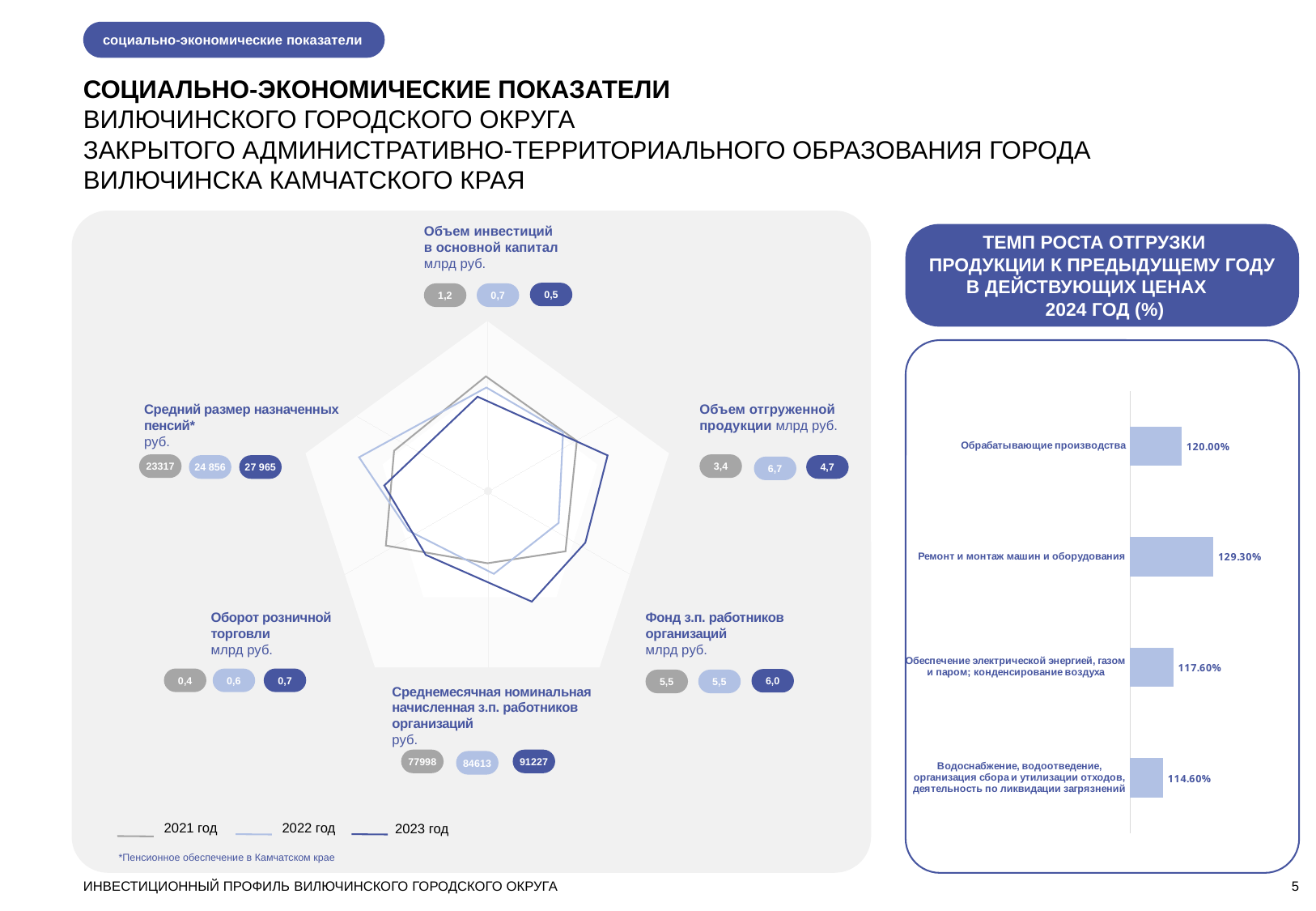
In the radar chart on the left, what is the value of Объем инвестиций в основной капитал for 2023 год? 0,5 In the radar chart on the left, what is the difference between the 2023 год and 2021 год values of Средний размер назначенных пенсий? 4 648 What kind of chart is shown on the right side of the slide? Bar chart In the bar chart on the right, how many categories are shown? 4 In the radar chart on the left, which is larger for Объем отгруженной продукции: the 2022 год value or the 2023 год value? 2022 год What kind of chart is shown on the left side of the slide? Radar chart In the bar chart on the right, what is the value for Ремонт и монтаж машин и оборудования? 129.30% In the bar chart on the right, which category has the lowest value? Водоснабжение, водоотведение, организация сбора и утилизации отходов, деятельность по ликвидации загрязнений In the radar chart on the left, what is the value of Среднемесячная номинальная начисленная з.п. работников организаций for 2022 год? 84613 In the bar chart on the right, what is the difference between the values for Обрабатывающие производства and Водоснабжение, водоотведение? 5.40% In the radar chart on the left, how many series does the legend list? 3 In the bar chart on the right, which category has the highest value? Ремонт и монтаж машин и оборудования